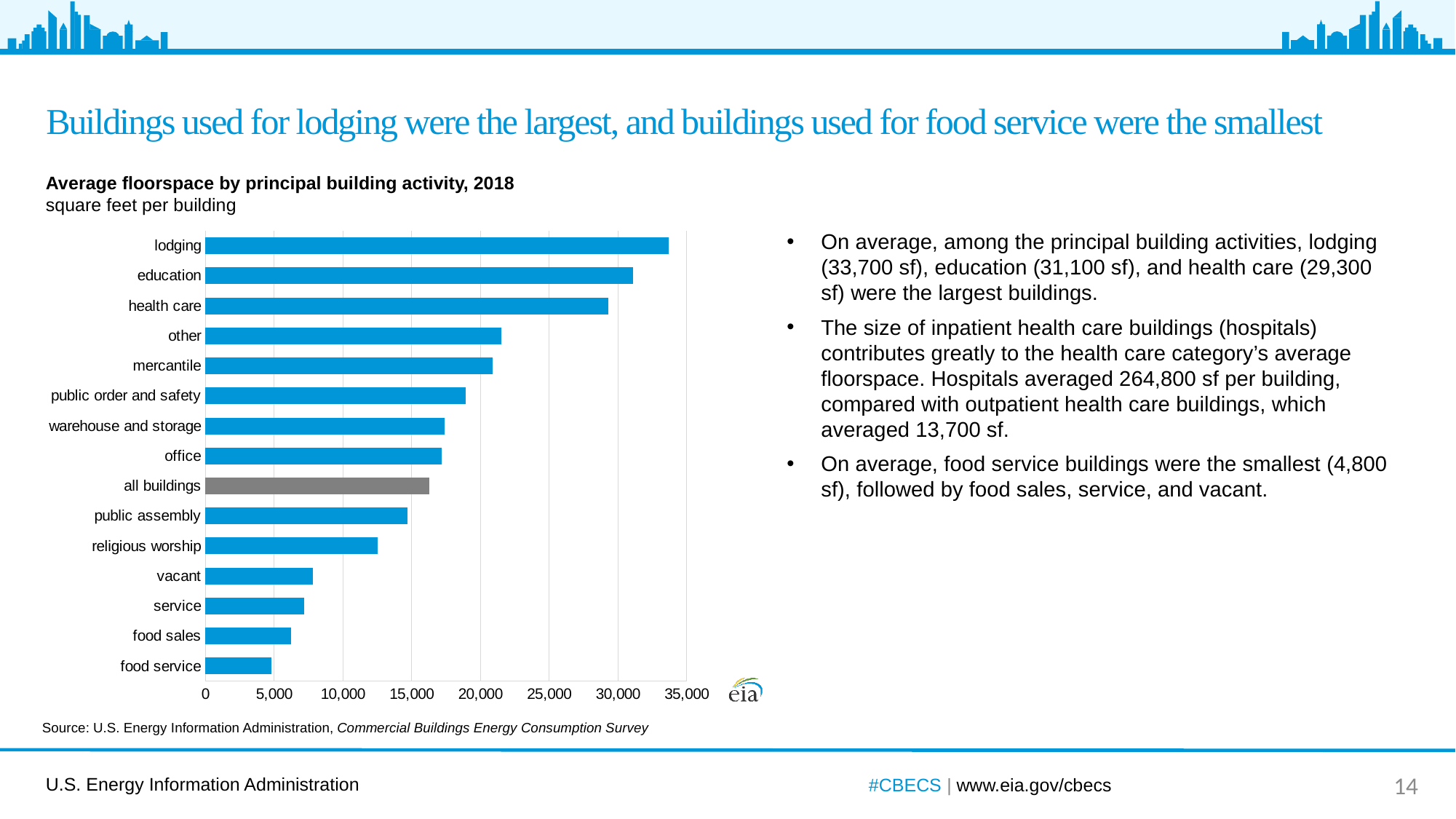
Which building activity has the smallest average floorspace? food service How many categories are plotted in the chart? 15 Is the value for 'vacant' greater or less than 10,000? less Is the value for 'other' greater or less than 20,000? greater Which has a larger average floorspace, education or health care? education Is the value for 'warehouse and storage' greater or less than 15,000? greater Which bar is shown in a different colour (grey) from the others? all buildings Which building activity has the largest average floorspace? lodging What kind of chart is shown on the slide? bar chart What is the title of the chart? Average floorspace by principal building activity, 2018